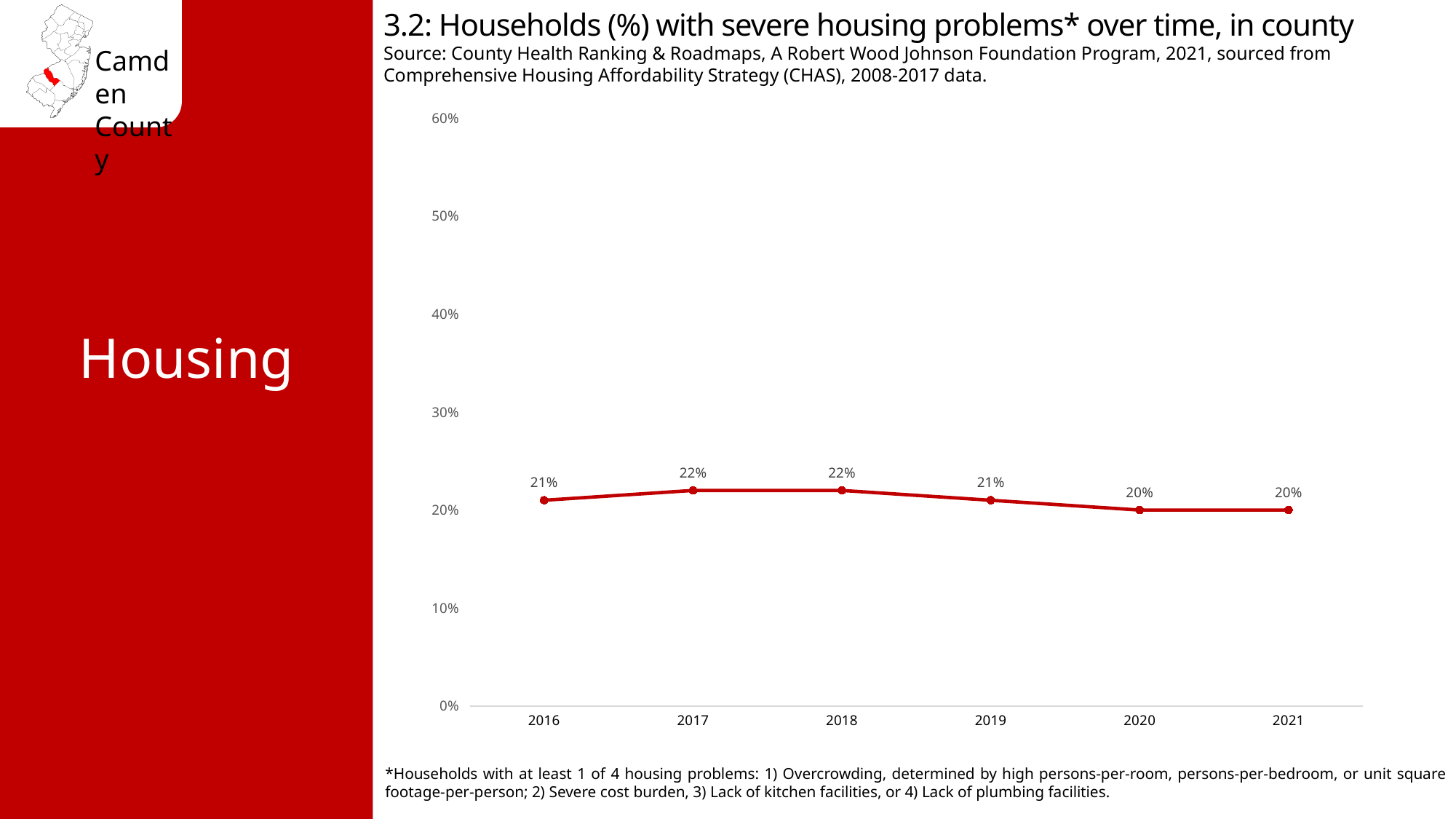
Is the value for 2017 greater or less than 30%? less Do the values rise or fall between 2018 and 2021? Fall How many years are plotted on the chart? 6 What is the value shown for 2019? 21% What percentage of households had severe housing problems in 2016? 21% What kind of chart is shown on the slide? Line chart What is the highest value shown on the vertical axis? 60% What percentage of households had severe housing problems in 2021? 20% Is the value for 2018 larger than the value for 2021? Yes What is the difference between the value for 2017 and the value for 2020? 2% Which years show the lowest value on the chart? 2020 and 2021 What is the value shown for 2018? 22%